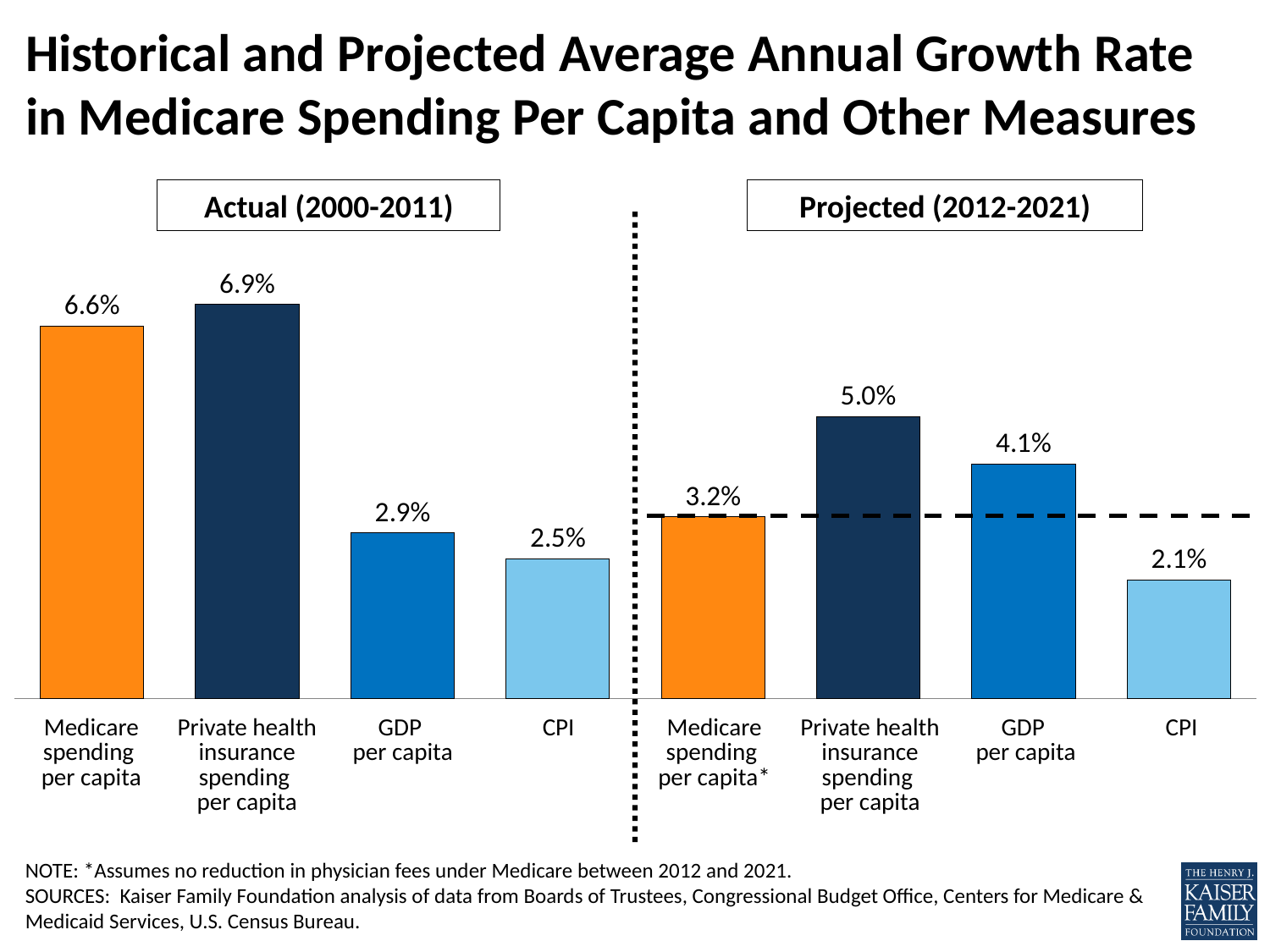
In the Projected (2012-2021) panel, which is larger: the growth rate for Medicare spending per capita or for GDP per capita? GDP per capita In the Projected (2012-2021) panel, what is the growth rate for private health insurance spending per capita? 5.0% How many bars are shown in the Actual (2000-2011) panel? 4 What is the difference between the actual (2000-2011) and projected (2012-2021) growth rates for Medicare spending per capita? 3.4 percentage points What kind of chart is shown on the slide? Bar chart What is the title of the chart? Historical and Projected Average Annual Growth Rate in Medicare Spending Per Capita and Other Measures In the Actual (2000-2011) panel, what is the difference between the growth rates for GDP per capita and CPI? 0.4 percentage points In the Projected (2012-2021) panel, which measure has the lowest growth rate? CPI In the Actual (2000-2011) panel, what is the average annual growth rate for Medicare spending per capita? 6.6% What colour are the bars for Medicare spending per capita? Orange In the Actual (2000-2011) panel, which measure has the highest growth rate? Private health insurance spending per capita In the Projected (2012-2021) panel, what is the growth rate for GDP per capita? 4.1%